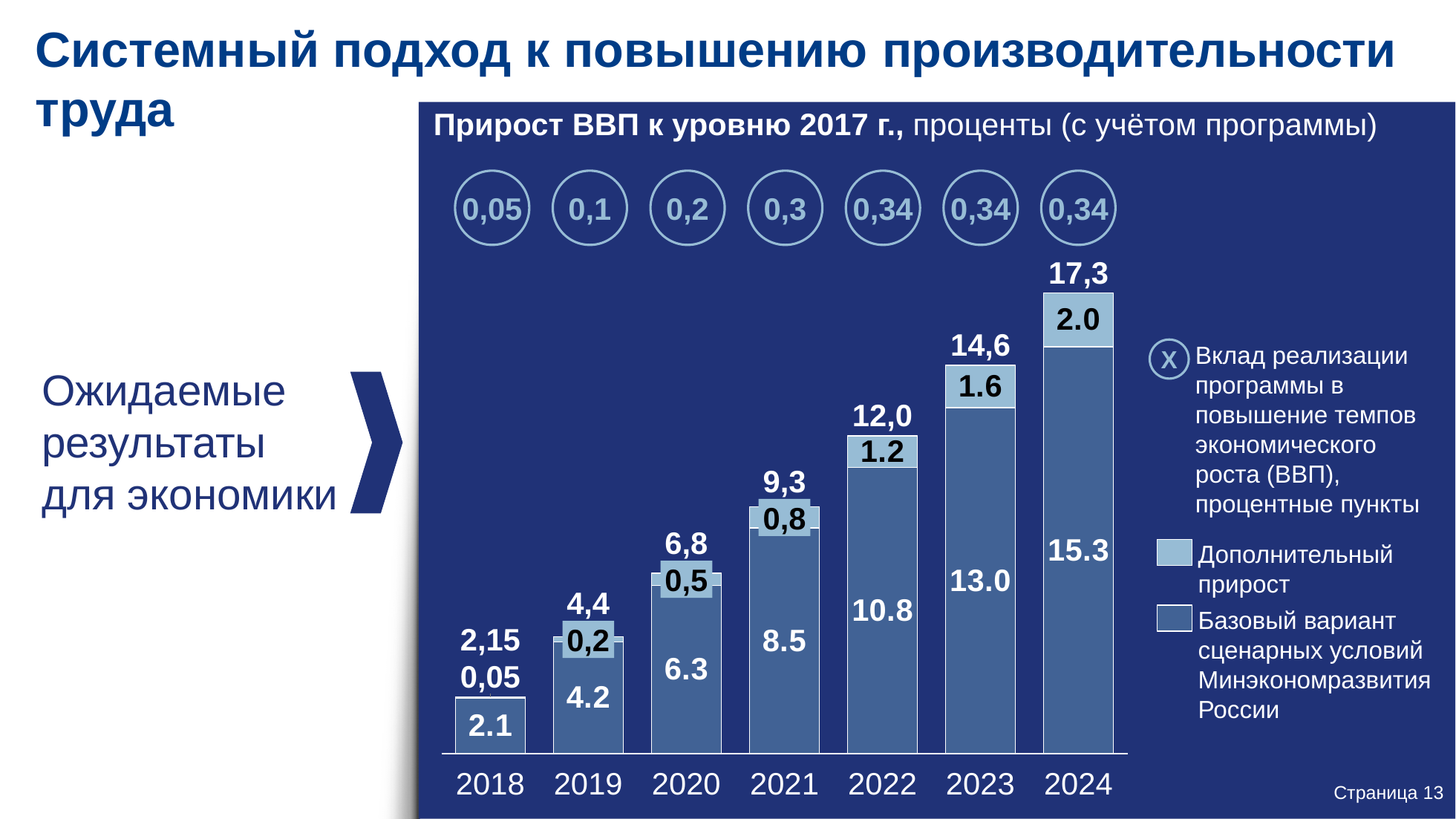
Do the total GDP growth values rise or fall from 2018 to 2024? Rise Which year has the lowest total GDP growth relative to 2017? 2018 Which year has the highest total GDP growth relative to 2017? 2024 Which is larger: the additional growth for 2022 or for 2021? 2022 What is the additional growth (Дополнительный прирост) value for 2024? 2.0 What kind of chart is shown on the slide? Stacked bar chart What is the difference between the base scenario values for 2024 and 2023? 2.3 How many years are shown on the x axis? 7 What is the value of the base scenario (Базовый вариант) for 2022? 10.8 What is the total GDP growth relative to 2017 shown for 2021? 9,3 How many series does the legend list? 2 What is the program's contribution to economic growth rate (circled value) shown for 2020? 0,2